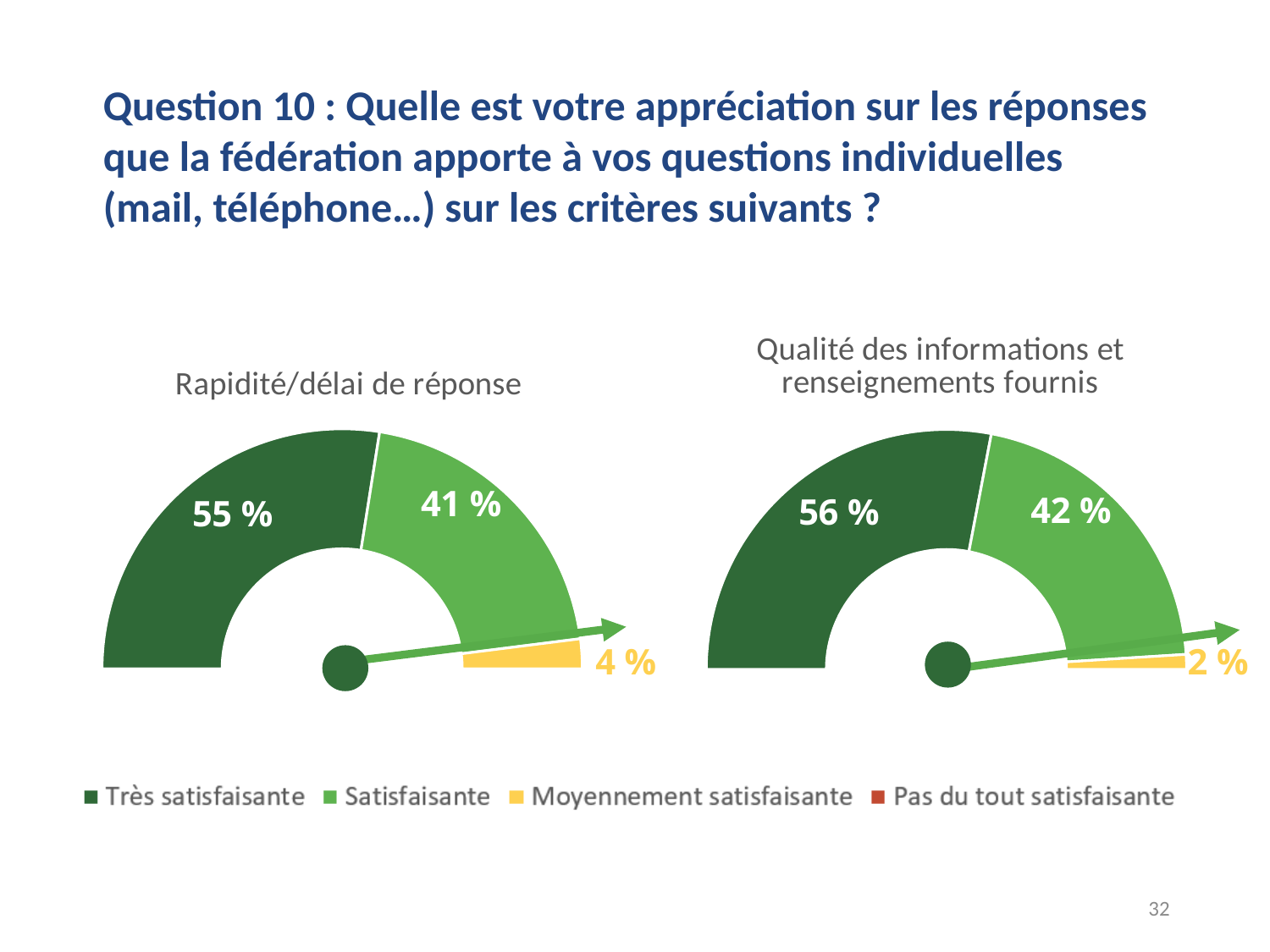
In the 'Rapidité/délai de réponse' chart, which category has the largest share? Très satisfaisante What kind of chart is used on this slide? Gauge (half-doughnut) chart In the 'Qualité des informations et renseignements fournis' chart, which labelled category has the smallest share? Moyennement satisfaisante In the 'Qualité des informations et renseignements fournis' chart, what percentage is shown for 'Très satisfaisante'? 56 % In the 'Rapidité/délai de réponse' chart, what is the difference between the 'Très satisfaisante' and 'Satisfaisante' percentages? 14 % Which chart has the higher 'Très satisfaisante' percentage, 'Rapidité/délai de réponse' or 'Qualité des informations et renseignements fournis'? Qualité des informations et renseignements fournis In the 'Qualité des informations et renseignements fournis' chart, what percentage is shown for 'Moyennement satisfaisante'? 2 % In the 'Rapidité/délai de réponse' chart, what percentage is shown for 'Moyennement satisfaisante'? 4 % How many entries does the legend list? 4 In the 'Rapidité/délai de réponse' chart, what percentage is shown for 'Satisfaisante'? 41 % In the 'Qualité des informations et renseignements fournis' chart, what percentage is shown for 'Satisfaisante'? 42 % In the 'Rapidité/délai de réponse' chart, what percentage is shown for 'Très satisfaisante'? 55 %